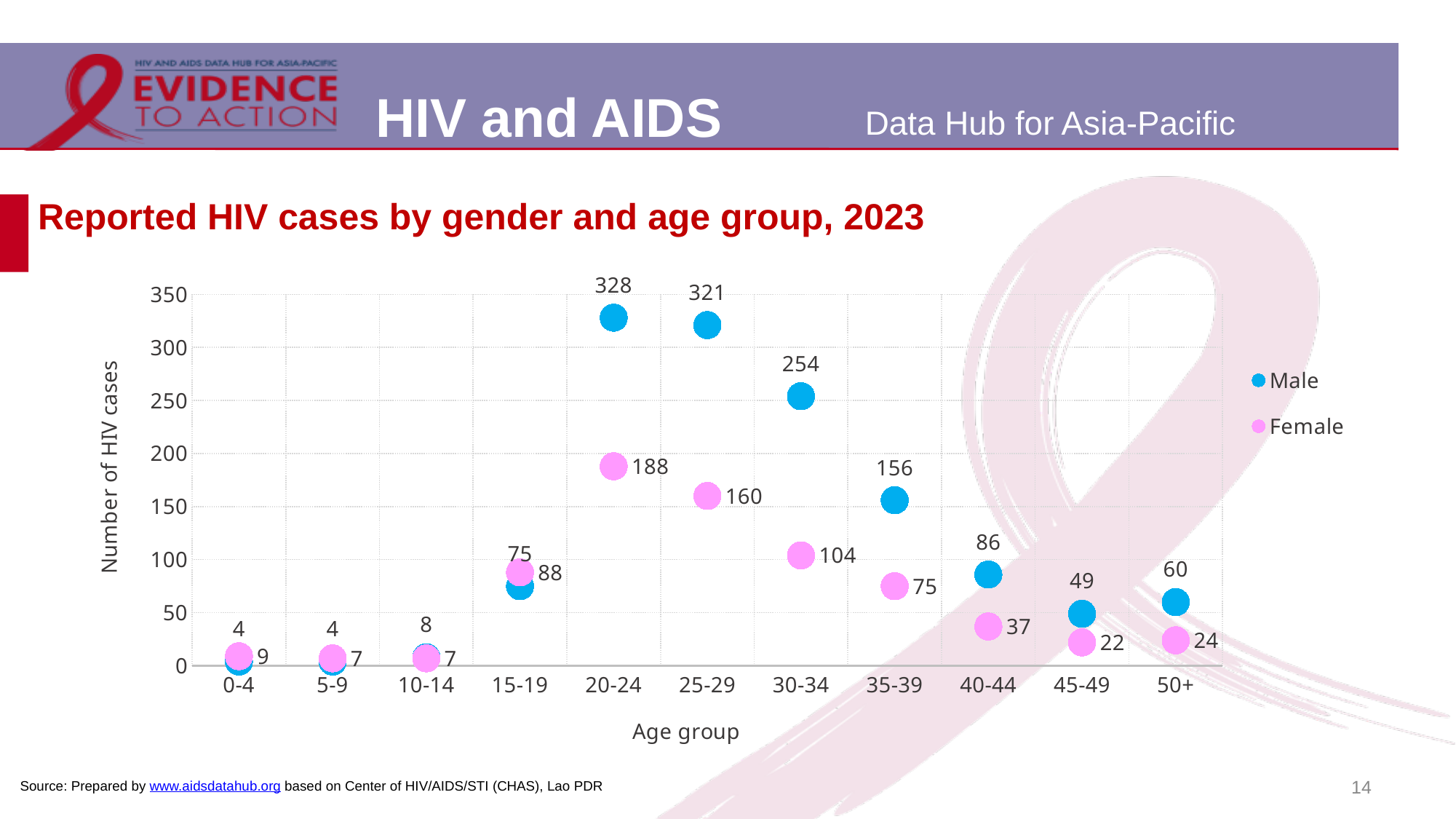
What is the number of reported HIV cases for females in the 15-19 age group? 88 What is the number of reported HIV cases for females in the 25-29 age group? 160 What is the difference between male reported HIV cases in the 20-24 and 25-29 age groups? 7 What kind of chart is shown on the slide? Scatter (dot) chart How many series does the legend list? 2 Which is larger in the 50+ age group, the male or the female number of reported HIV cases? Male What is the number of reported HIV cases for males in the 20-24 age group? 328 Which age group has the highest number of reported HIV cases among females? 20-24 Which is larger in the 15-19 age group, the male or the female number of reported HIV cases? Female What is the difference between male and female reported HIV cases in the 30-34 age group? 150 How many age groups are shown on the x axis? 11 Which age group has the highest number of reported HIV cases among males? 20-24